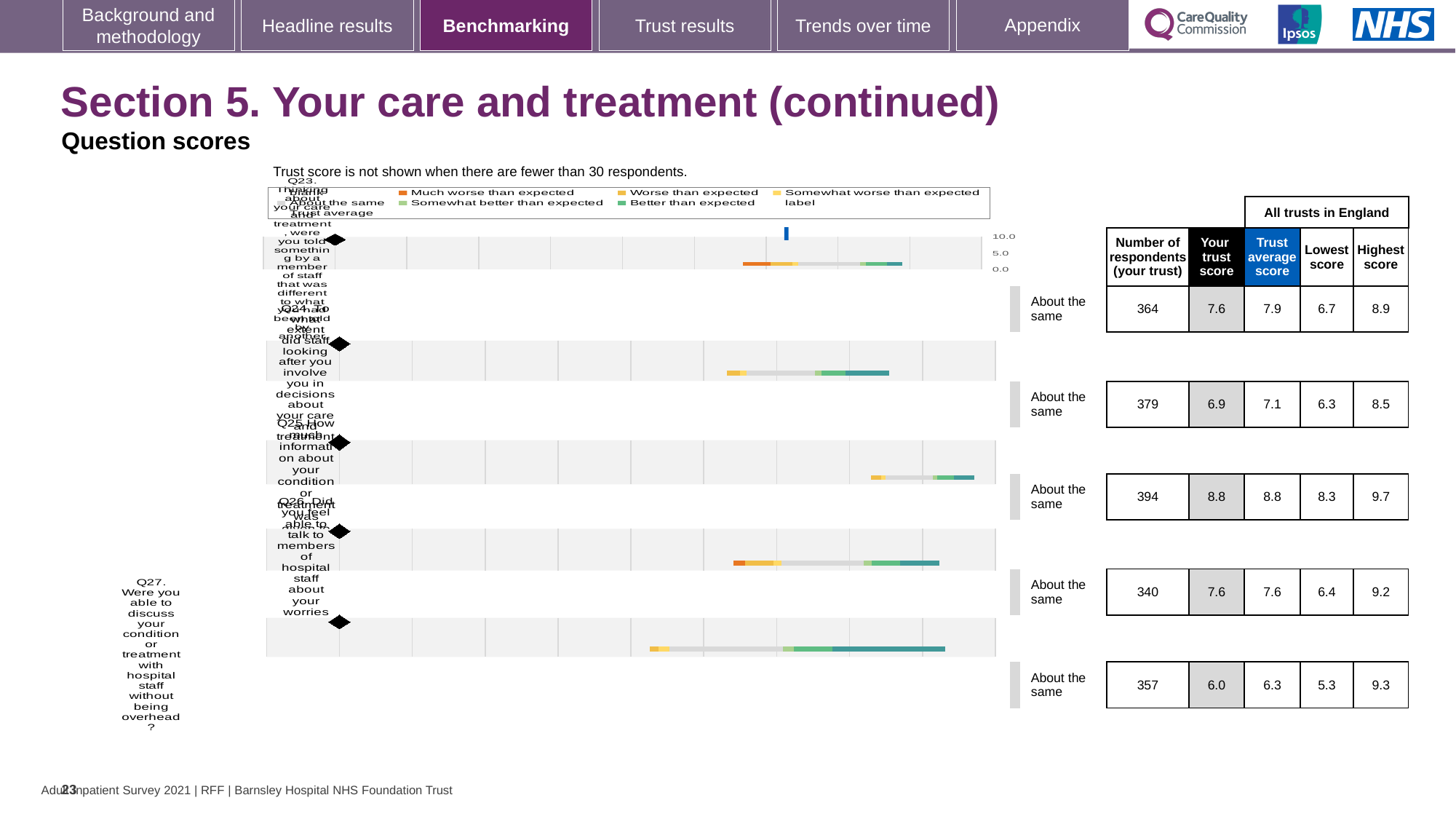
How many questions are plotted on the chart? 5 Which question has the highest number of respondents? Q25 What is the trust average score for Q25? 8.8 What benchmark category is shown for Q27? About the same How many respondents (your trust) are shown for Q24? 379 Which question has the lowest 'Your trust score'? Q27 What is the highest score across all trusts in England for Q27? 9.3 Which question has the highest 'Your trust score'? Q25 What is the 'Your trust score' for Q23? 7.6 What is the lowest score across all trusts in England for Q26? 6.4 For Q24, which is larger: your trust score or the trust average score? Trust average score What is the difference between the trust average score and your trust score for Q23? 0.3